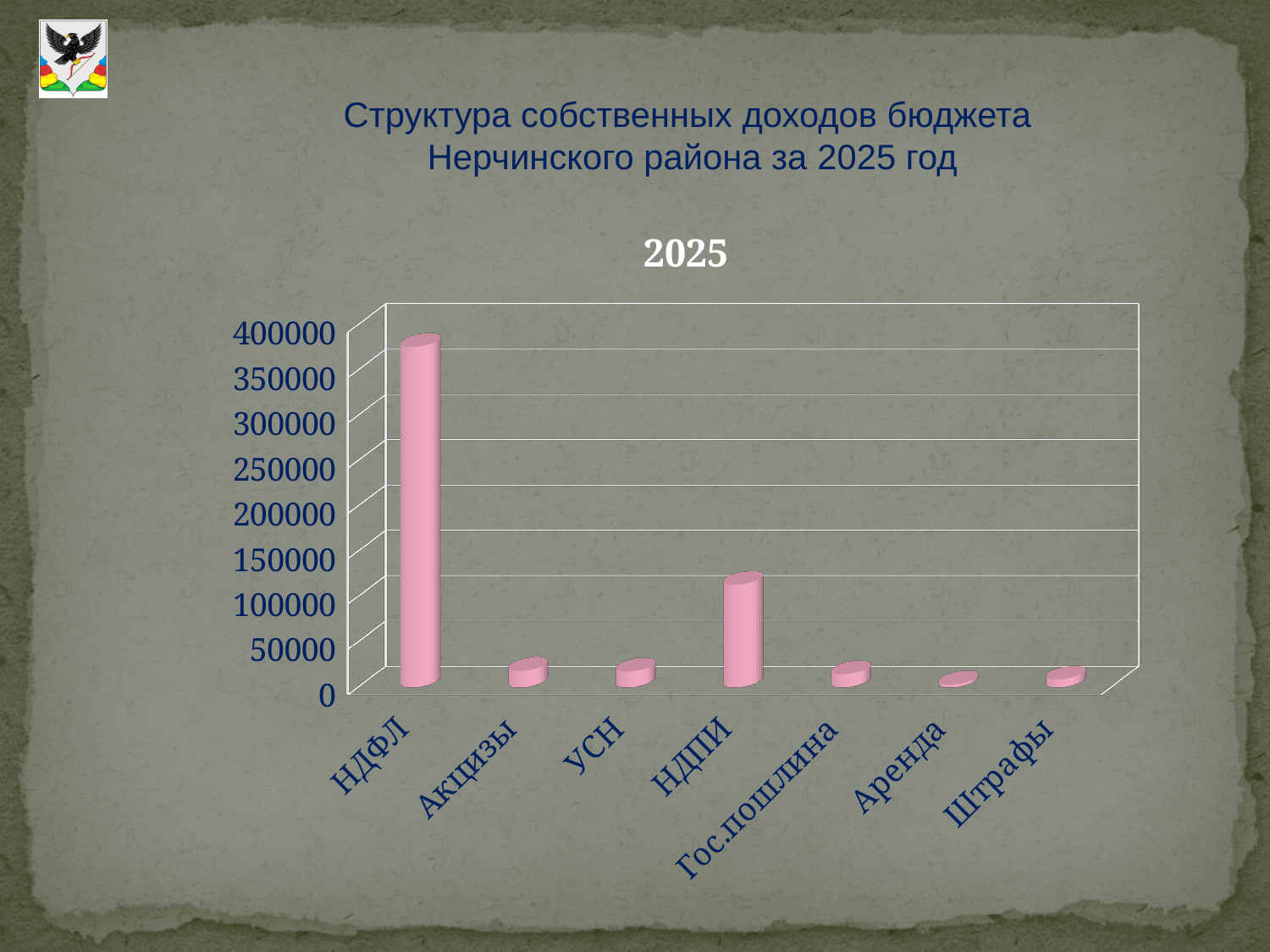
Is the value for Акцизы greater or less than 50000? less Is the value for НДФЛ greater or less than 350000? greater What is the title shown directly above the chart? 2025 Is the value for НДПИ greater or less than 100000? greater Which is larger, the value for НДФЛ or the value for НДПИ? НДФЛ What kind of chart is shown on the slide? bar chart Which category has the lowest value in the chart? Аренда Which category has the highest value in the chart? НДФЛ How many categories are shown on the x axis of the chart? 7 Which is larger, the value for НДПИ or the value for Акцизы? НДПИ